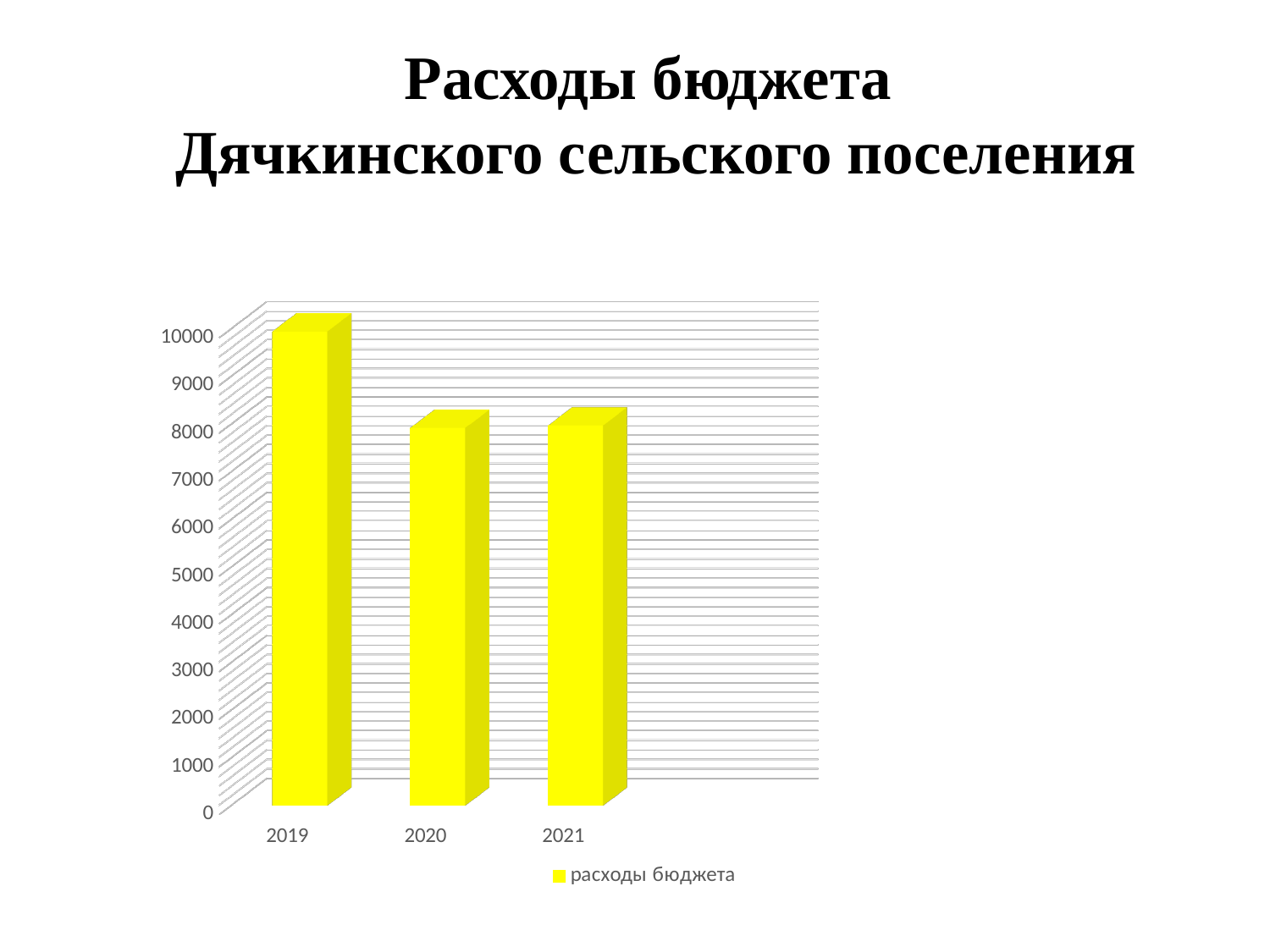
Is the value for 2020 greater or less than 9000? less Is the value for 2021 greater or less than 7000? greater Does the budget expenditure rise or fall from 2019 to 2020? fall Is the value for 2019 greater or less than 9000? greater Which year has the highest budget expenditure in the chart? 2019 How many years are shown on the x axis of the chart? 3 What kind of chart is shown on the slide? bar chart Which is larger, the value for 2019 or the value for 2020? 2019 What is the name of the series shown in the chart legend? расходы бюджета How many series does the chart legend list? 1